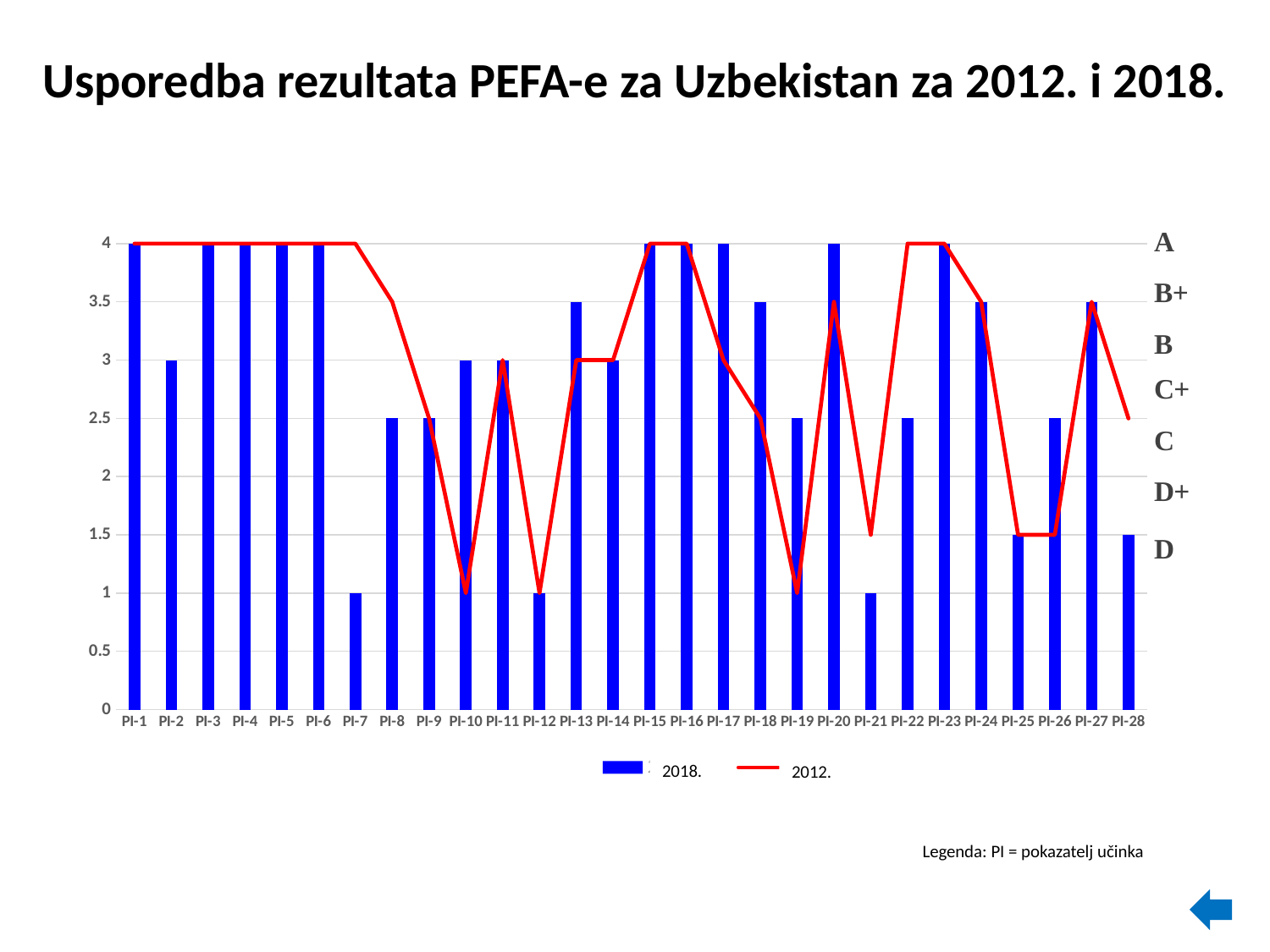
How many series does the legend list? 2 What is the 2018. value for PI-13? 3.5 What is the 2012. value for PI-10? 1 What is the title of the chart slide? Usporedba rezultata PEFA-e za Uzbekistan za 2012. i 2018. For PI-7, which series has the larger value, 2018. or 2012.? 2012. What is the 2012. value for PI-21? 1.5 What is the 2018. value for PI-7? 1 How many performance indicators (PI categories) are shown on the x axis? 28 For PI-19, which series has the larger value, 2018. or 2012.? 2018. What is the difference between the 2012. and 2018. values for PI-7? 3 Is the 2018. value for PI-28 greater or less than 2? less What kind of chart is used to show the 2018. series? bar chart